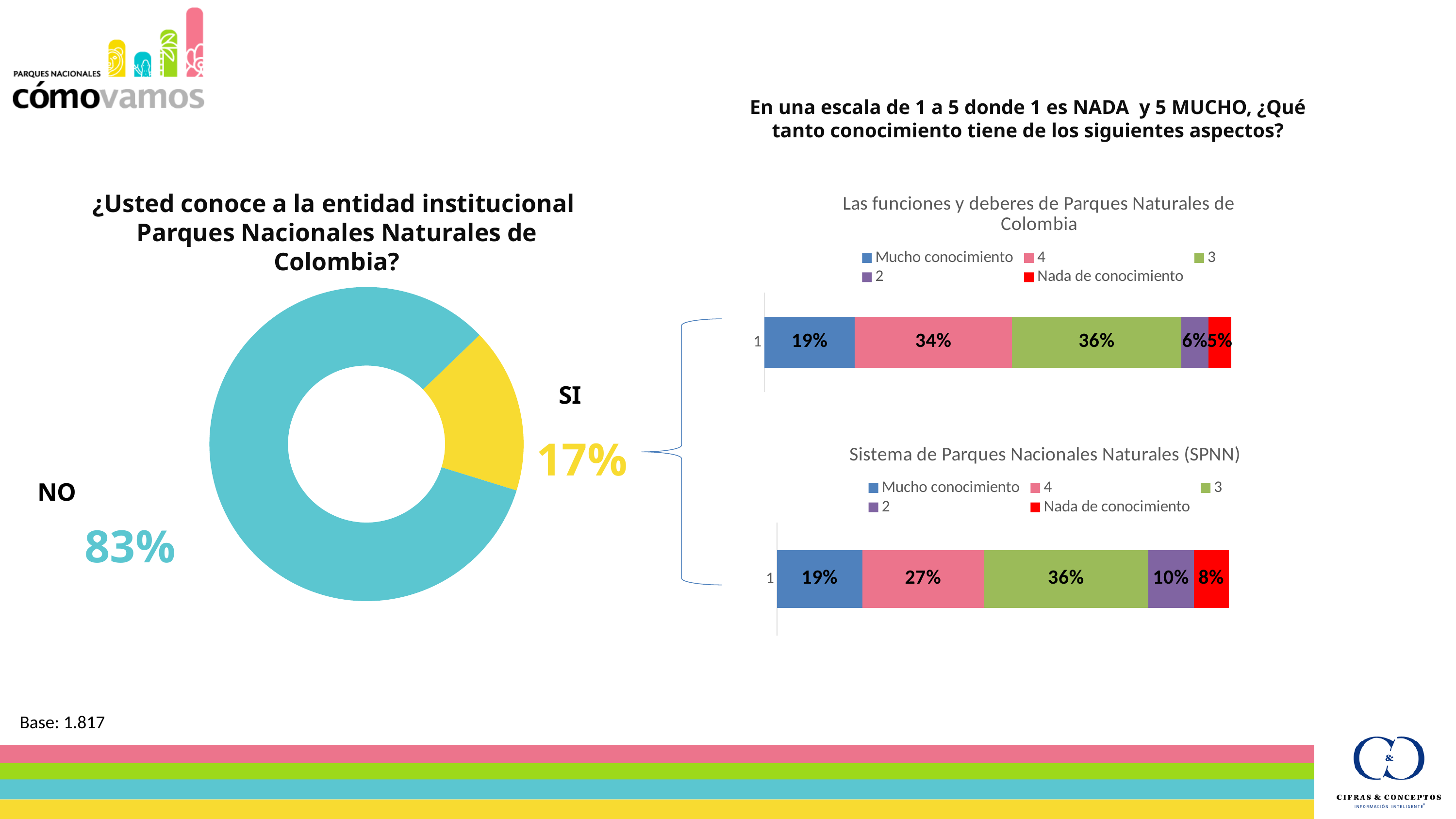
In the donut chart '¿Usted conoce a la entidad institucional Parques Nacionales Naturales de Colombia?', what percentage answered SI? 17% In the donut chart on the left, which answer has the larger share, SI or NO? NO In the chart 'Las funciones y deberes de Parques Naturales de Colombia', which series has the highest value? 3 In the chart 'Las funciones y deberes de Parques Naturales de Colombia', what is the value for 'Mucho conocimiento'? 19% What kind of chart is the chart on the left of the slide? Donut (pie) chart In the chart 'Sistema de Parques Nacionales Naturales (SPNN)', what is the value for 'Nada de conocimiento'? 8% In the chart 'Las funciones y deberes de Parques Naturales de Colombia', which series has the lowest value? Nada de conocimiento How many series does the legend of the chart 'Sistema de Parques Nacionales Naturales (SPNN)' list? 5 In the chart 'Las funciones y deberes de Parques Naturales de Colombia', what is the value for '4'? 34% In the chart 'Sistema de Parques Nacionales Naturales (SPNN)', what is the difference between the values for '3' and '4'? 9% In the chart 'Sistema de Parques Nacionales Naturales (SPNN)', what is the value for '2'? 10% In the donut chart '¿Usted conoce a la entidad institucional Parques Nacionales Naturales de Colombia?', what percentage answered NO? 83%